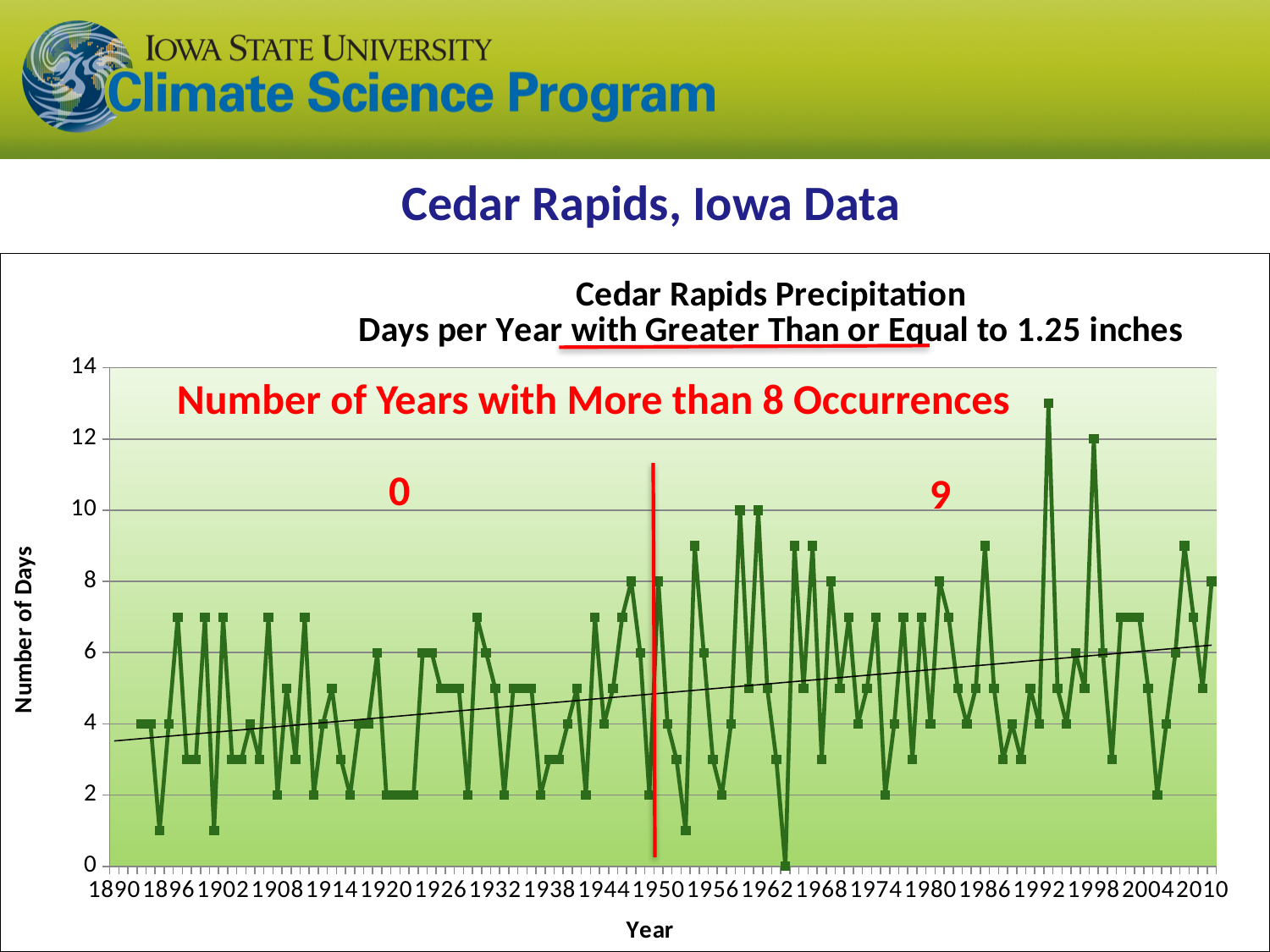
Is the value for 1950 greater or less than 6? greater What is the difference between the number of years with more than 8 occurrences after 1950 and before 1950? 9 According to the annotation on the chart, how many years before 1950 had more than 8 occurrences? 0 Does the trend line on the chart rise or fall from 1890 to 2010? rises According to the annotation on the chart, how many years after 1950 had more than 8 occurrences? 9 Is the highest value on the chart greater or less than 12? greater What is the highest value shown on the y axis of the chart? 14 What is the title of the chart? Cedar Rapids Precipitation Days per Year with Greater Than or Equal to 1.25 inches What year does the red vertical line on the chart mark? 1950 What is the lowest number of days reached on the chart? 0 Which period has more years with more than 8 occurrences, before 1950 or after 1950? after 1950 What kind of chart is shown on the slide? line chart